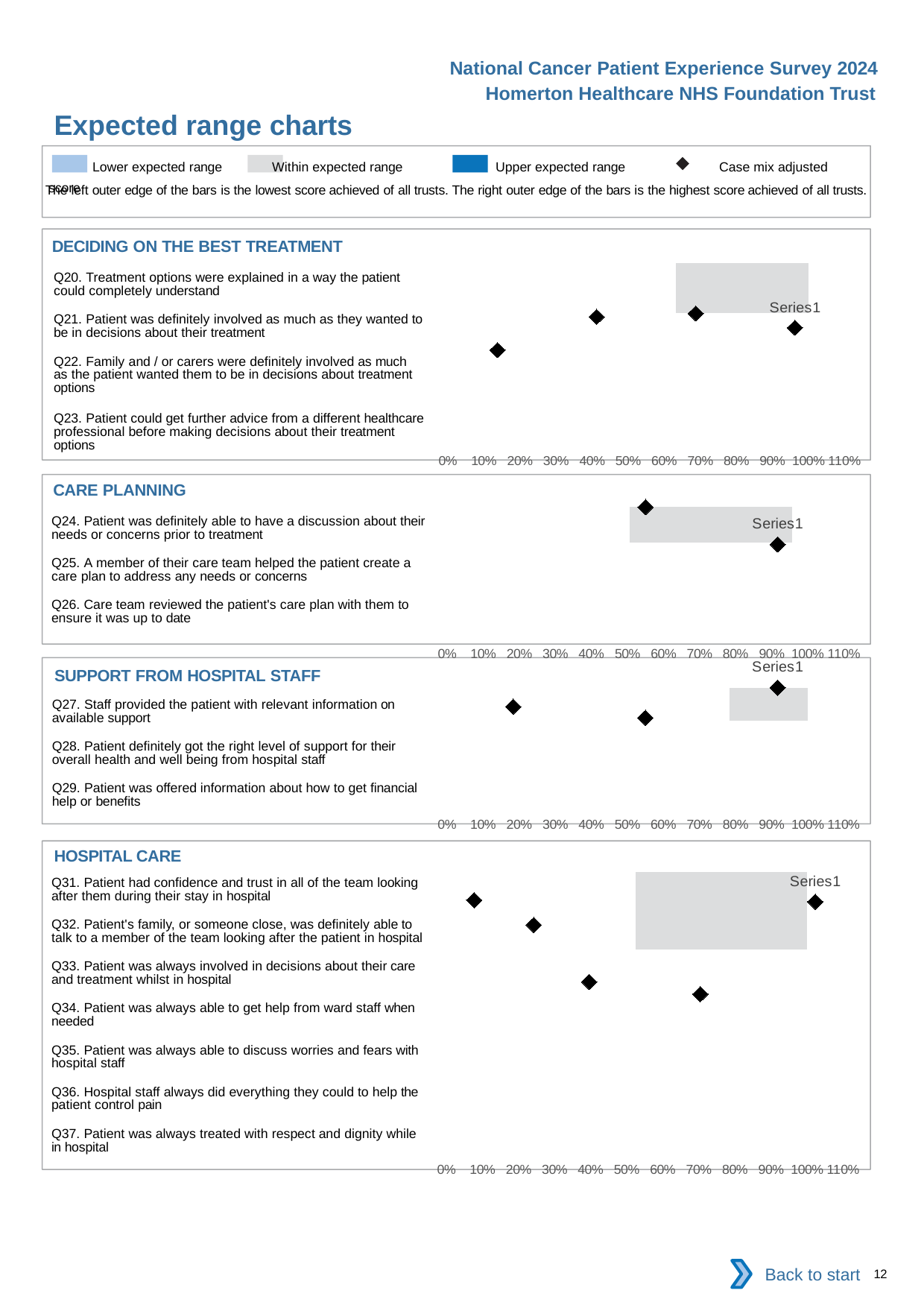
How many questions are listed in the DECIDING ON THE BEST TREATMENT chart? 4 What is the highest percentage label shown on the x axis of the charts? 110% How many questions are listed in the SUPPORT FROM HOSPITAL STAFF chart? 3 In the DECIDING ON THE BEST TREATMENT chart, is the leftmost diamond greater or less than 30%? less In the CARE PLANNING chart, is the rightmost diamond greater or less than 80%? greater In the HOSPITAL CARE chart, is the leftmost diamond greater or less than 20%? less How many questions are listed in the CARE PLANNING chart? 3 According to the legend, what does the black diamond marker represent? Case mix adjusted score